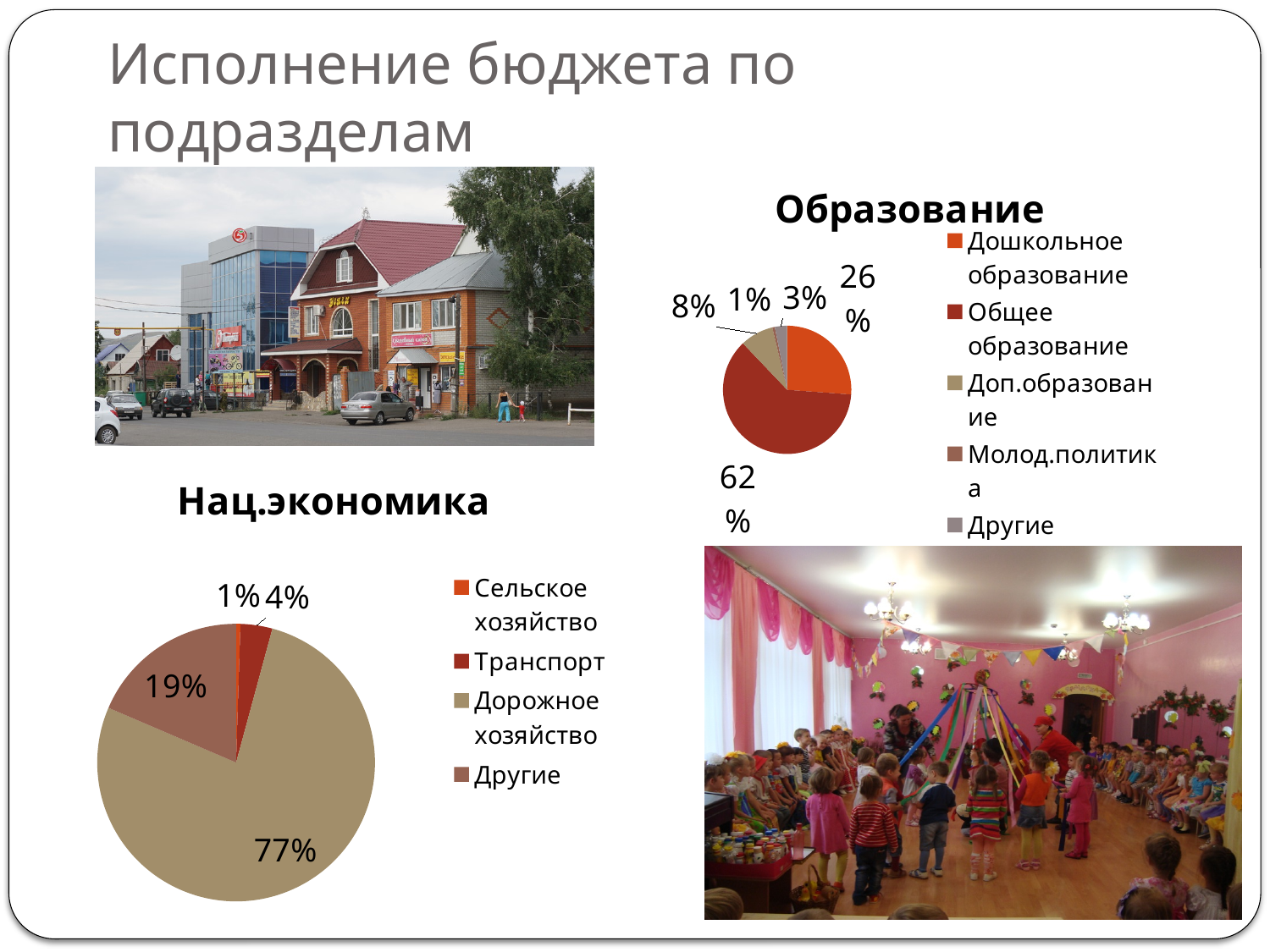
In the "Нац.экономика" chart, what share does Другие have? 19% How many categories does the legend of the "Нац.экономика" chart list? 4 In the "Образование" chart, which category has the largest share? Общее образование What type of chart is the "Нац.экономика" chart? Pie chart In the "Образование" chart, what share does Дошкольное образование have? 26% In the "Нац.экономика" chart, which is larger: Транспорт or Другие? Другие In the "Нац.экономика" chart, what share does Дорожное хозяйство have? 77% How many categories does the legend of the "Образование" chart list? 5 In the "Образование" chart, what share does Общее образование have? 62% In the "Образование" chart, what is the difference between the shares of Общее образование and Дошкольное образование? 36% In the "Нац.экономика" chart, which category has the smallest share? Сельское хозяйство In the "Образование" chart, which category has the smallest share? Молод.политика